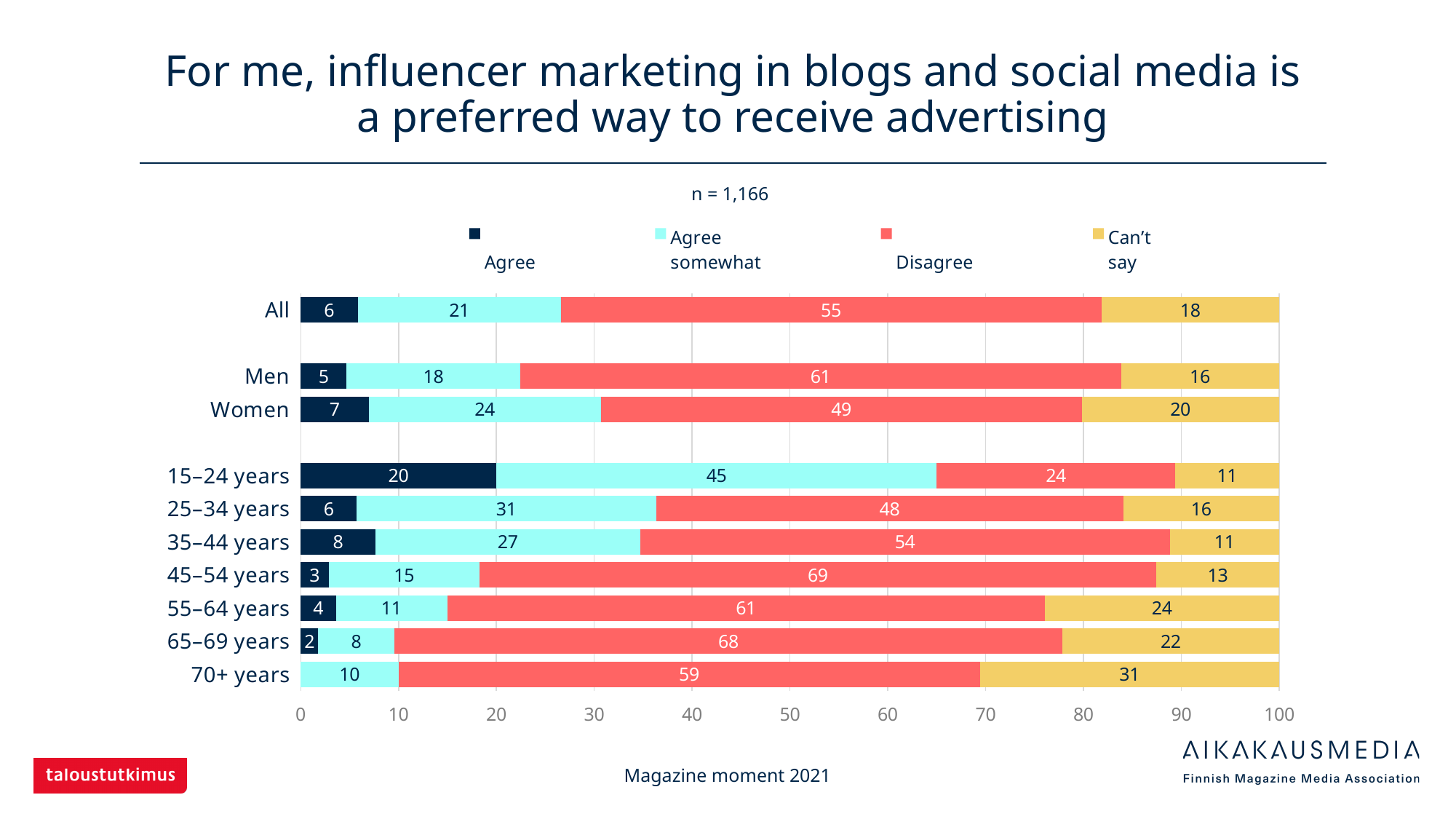
Which is larger, the 'Agree somewhat' value for Men or for Women? Women What is the 'Can't say' value for the 70+ years group? 31 What kind of chart is shown on the slide? Stacked bar chart What is the 'Disagree' value for the 'All' category? 55 Which age group has the highest 'Disagree' value? 45–54 years What is the total of the stacked bar for the 25–34 years group? 101 Which age group has the highest 'Agree' value? 15–24 years How many series does the legend list? 4 What is the difference between the 'Disagree' values for Men and Women? 12 What sample size (n) is shown on the slide? n = 1,166 Which age group has the lowest 'Can't say' value? 15–24 years and 35–44 years (both 11) What is the 'Agree somewhat' value for the 15–24 years group? 45